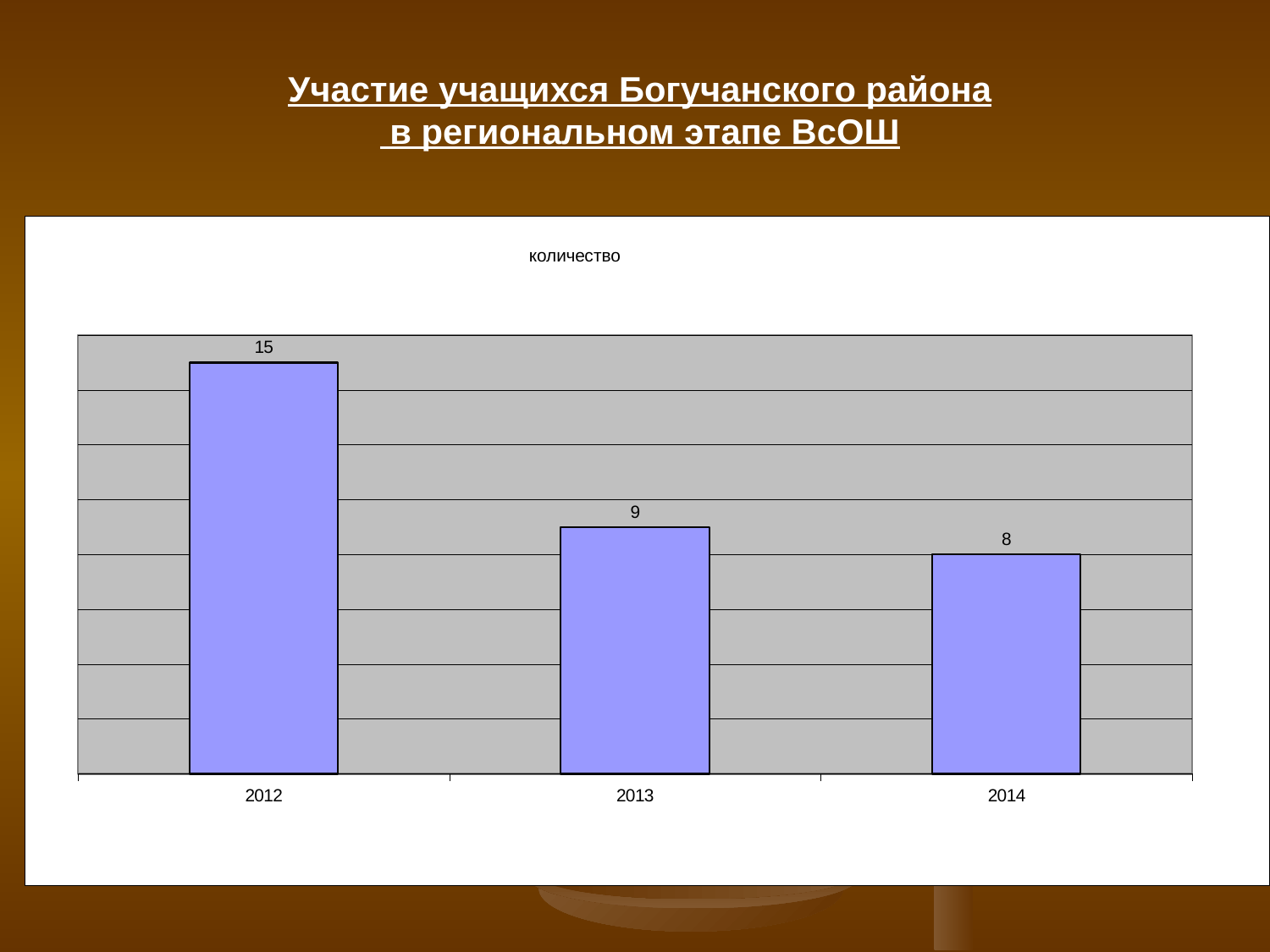
What is the difference between the values for 2012 and 2013? 6 What is the value for 2014? 8 Which year has the lowest value? 2014 What is the value for 2013? 9 What is the difference between the values for 2013 and 2014? 1 Do the values rise or fall from 2012 to 2014? fall How many years are shown on the x axis? 3 Which year has the highest value? 2012 What is the value for 2012? 15 What is the title of the chart? количество What kind of chart is this? bar chart Which is larger, the value for 2012 or the value for 2014? 2012